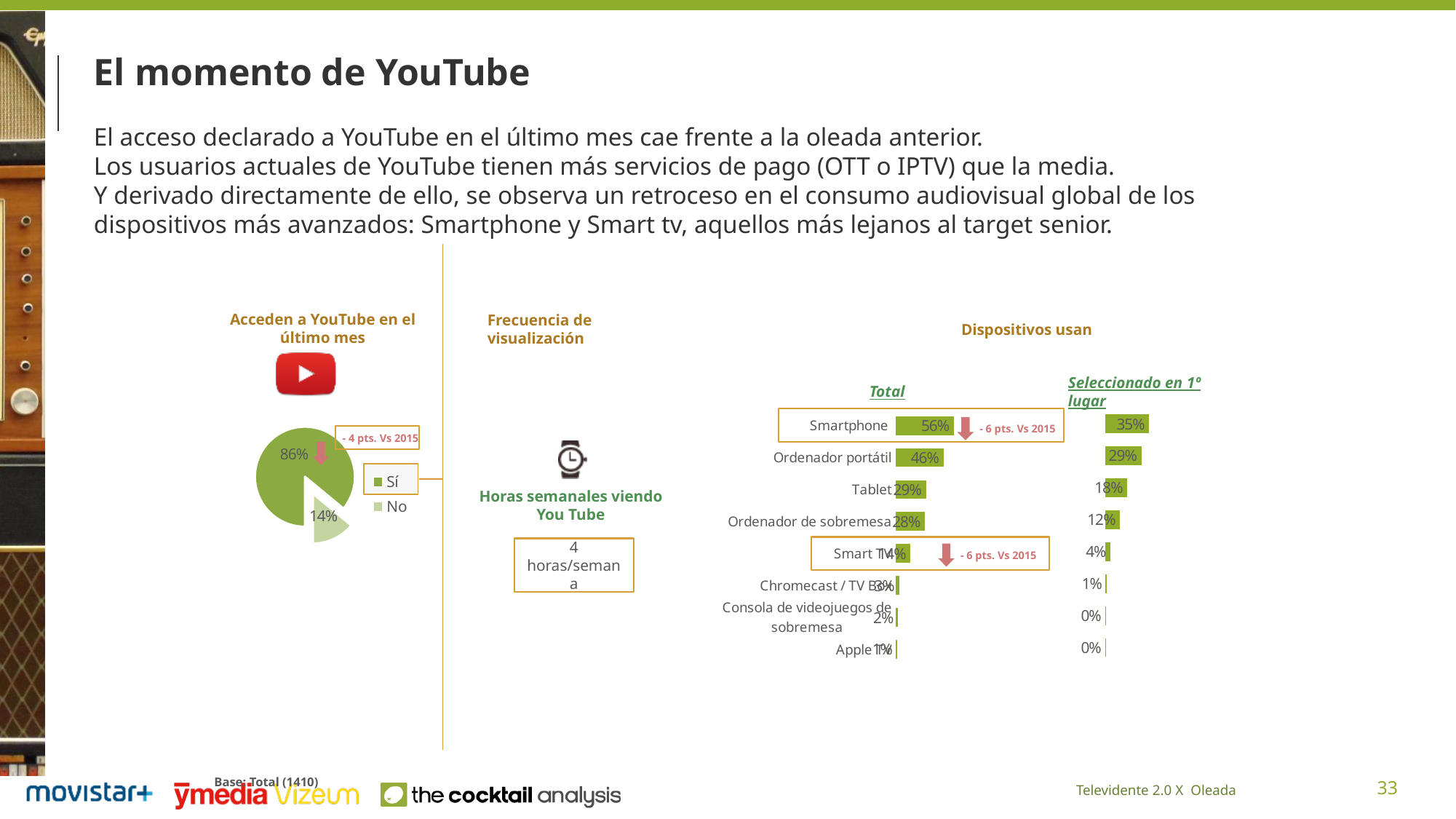
In the pie chart 'Acceden a YouTube en el último mes', what percentage answered 'No'? 14% In the 'Total' bar chart under 'Dispositivos usan', which device has the highest value? Smartphone In the pie chart 'Acceden a YouTube en el último mes', what percentage answered 'Sí'? 86% In the 'Total' bar chart under 'Dispositivos usan', what is the value for Smartphone? 56% In the 'Total' bar chart under 'Dispositivos usan', what is the difference between Smartphone and Ordenador portátil? 10 percentage points What kind of chart is used for 'Acceden a YouTube en el último mes'? Pie chart In the 'Seleccionado en 1º lugar' bar chart, what is the value for Smartphone? 35% In the 'Total' bar chart under 'Dispositivos usan', what is the value for Ordenador portátil? 46% What kind of chart is used for 'Dispositivos usan'? Bar chart In the 'Total' bar chart under 'Dispositivos usan', how many devices are listed? 8 In the pie chart 'Acceden a YouTube en el último mes', how many slices are there? 2